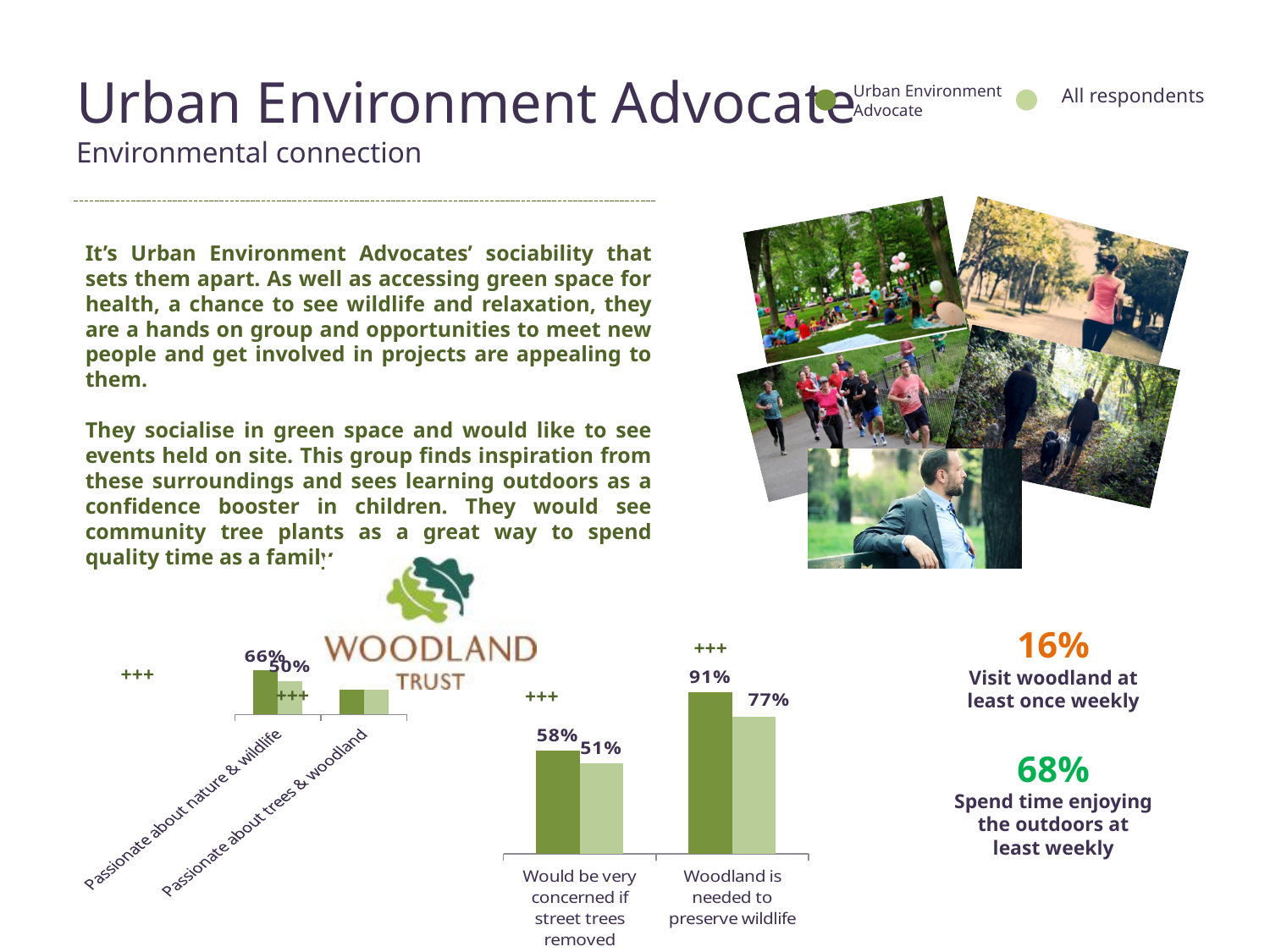
In the right-hand chart, which is larger for 'Would be very concerned if street trees removed': Urban Environment Advocates or All respondents? Urban Environment Advocates In the right-hand chart, which category has the highest value for Urban Environment Advocates? Woodland is needed to preserve wildlife In the right-hand chart, what is the value for All respondents for 'Would be very concerned if street trees removed'? 51% In the right-hand chart, what is the difference between Urban Environment Advocates and All respondents for 'Would be very concerned if street trees removed'? 7 percentage points In the left-hand chart, what is the value for All respondents for 'Passionate about nature & wildlife'? 50% How many categories does the right-hand chart show? 2 In the right-hand chart, what is the value for Urban Environment Advocates for 'Woodland is needed to preserve wildlife'? 91% In the left-hand chart, what is the value for Urban Environment Advocates for 'Passionate about nature & wildlife'? 66% In the right-hand chart, what is the value for All respondents for 'Woodland is needed to preserve wildlife'? 77% In the right-hand chart, what is the difference between Urban Environment Advocates and All respondents for 'Woodland is needed to preserve wildlife'? 14 percentage points What type of chart is the right-hand chart? Bar chart In the right-hand chart, what is the value for Urban Environment Advocates for 'Would be very concerned if street trees removed'? 58%